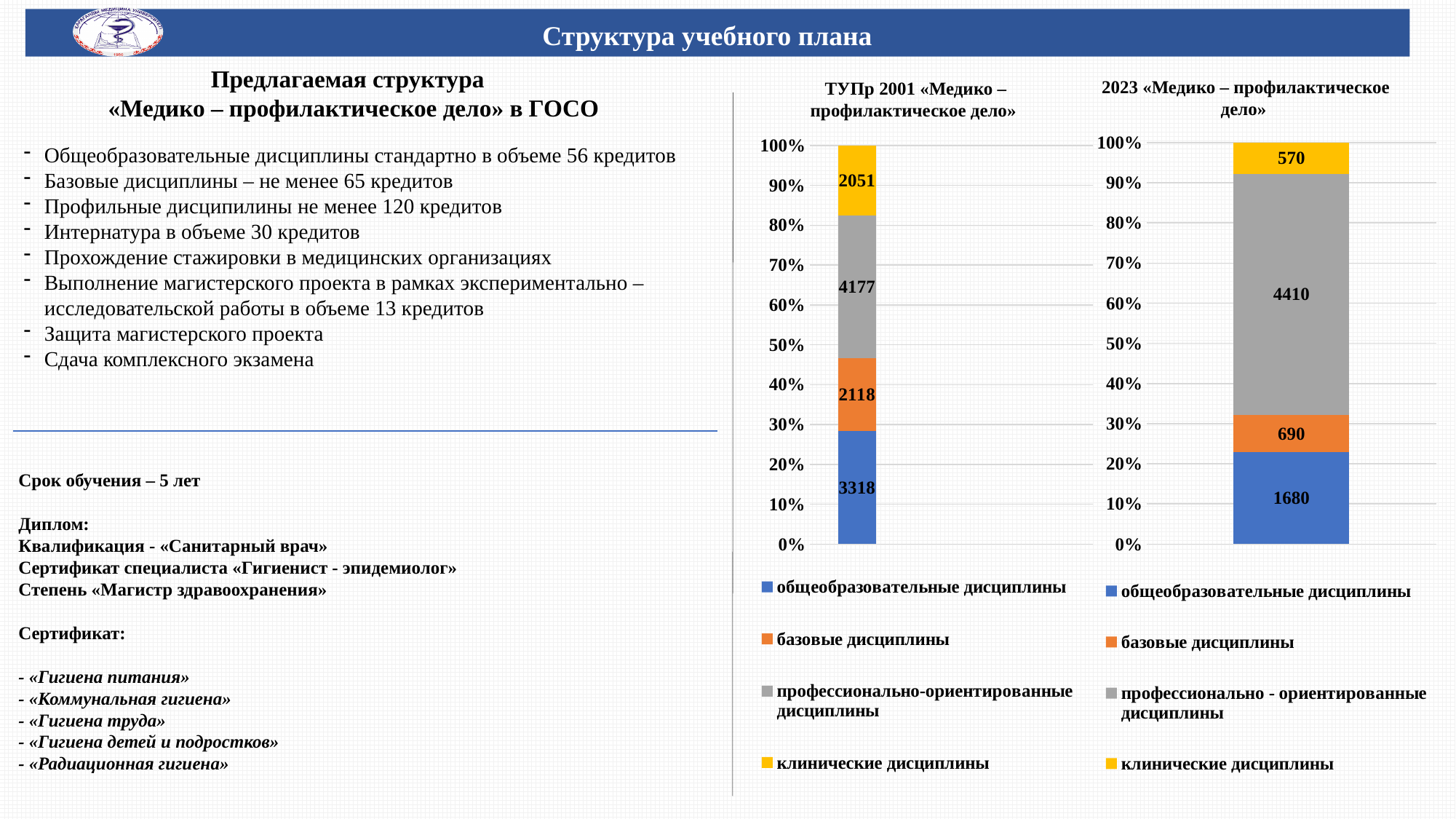
In the chart titled «2023 «Медико – профилактическое дело»», what is the value for профессионально - ориентированные дисциплины? 4410 In the chart titled «ТУПр 2001 «Медико – профилактическое дело»», what is the value for клинические дисциплины? 2051 In the chart titled «2023 «Медико – профилактическое дело»», what is the difference between общеобразовательные дисциплины and клинические дисциплины? 1110 Which is larger: общеобразовательные дисциплины in the «ТУПр 2001» chart or общеобразовательные дисциплины in the «2023» chart? ТУПр 2001 In the chart titled «2023 «Медико – профилактическое дело»», what is the value for базовые дисциплины? 690 In the chart titled «ТУПр 2001 «Медико – профилактическое дело»», what is the value for общеобразовательные дисциплины? 3318 In the chart titled «ТУПр 2001 «Медико – профилактическое дело»», what is the difference between профессионально-ориентированные дисциплины and базовые дисциплины? 2059 In the chart titled «ТУПр 2001 «Медико – профилактическое дело»», which series has the largest value? профессионально-ориентированные дисциплины In the chart titled «2023 «Медико – профилактическое дело»», which series has the smallest value? клинические дисциплины In the chart titled «2023 «Медико – профилактическое дело»», what is the total of the stacked bar? 7350 How many series does the legend of the chart titled «ТУПр 2001 «Медико – профилактическое дело»» list? 4 What kind of chart is the chart titled «2023 «Медико – профилактическое дело»»? stacked bar chart